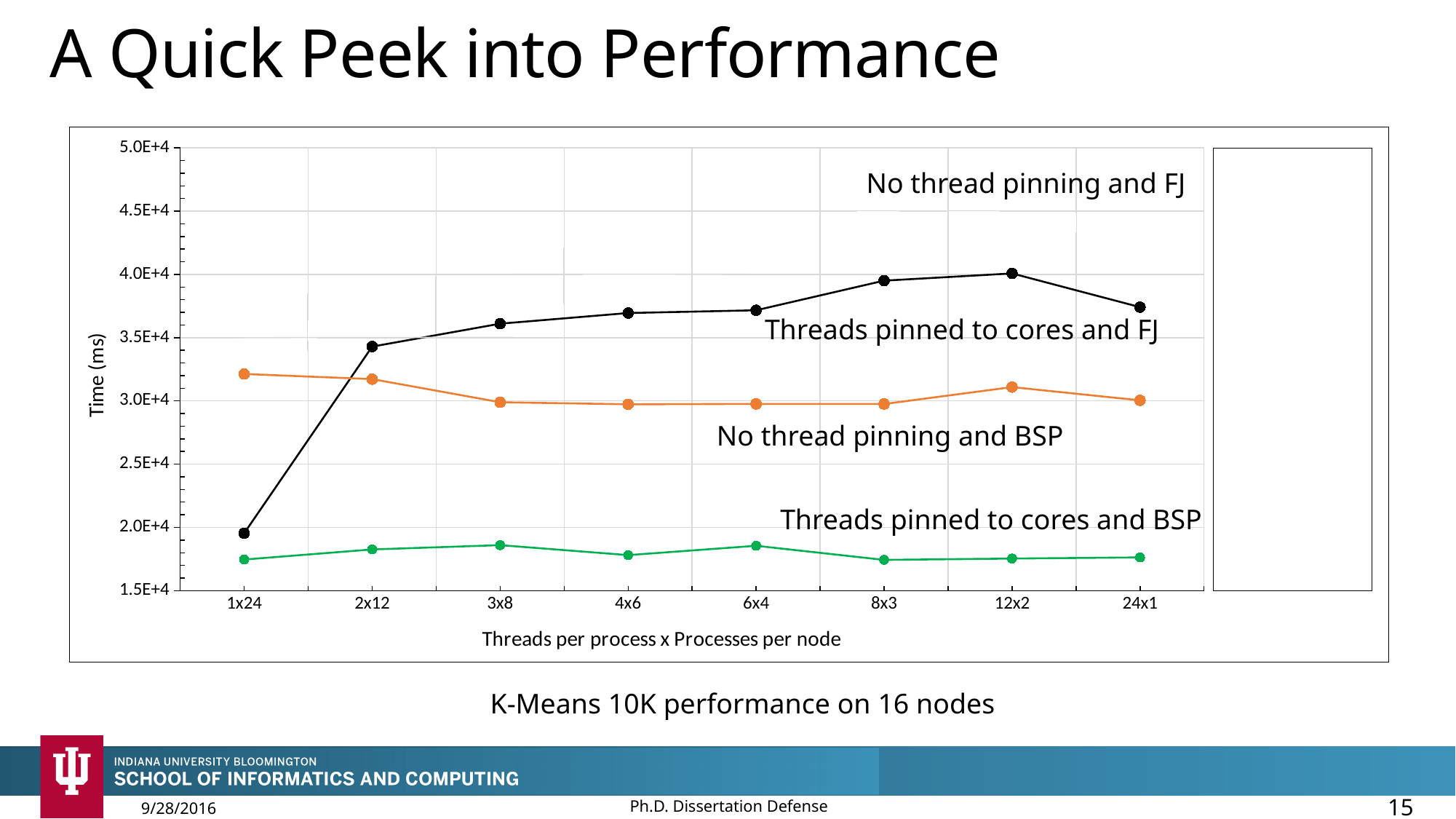
Is the value for 'No thread pinning and BSP' at 1x24 greater or less than 3.0E+4? greater Is the value for 'Threads pinned to cores and BSP' at 4x6 greater or less than 2.0E+4? less How many thread-per-process x processes-per-node configurations are plotted along the x axis? 8 What is the title of the y axis? Time (ms) For the 'No thread pinning and BSP' series, which configuration has the highest time? 1x24 What kind of chart is shown on the slide? line chart What is the title of the x axis? Threads per process x Processes per node